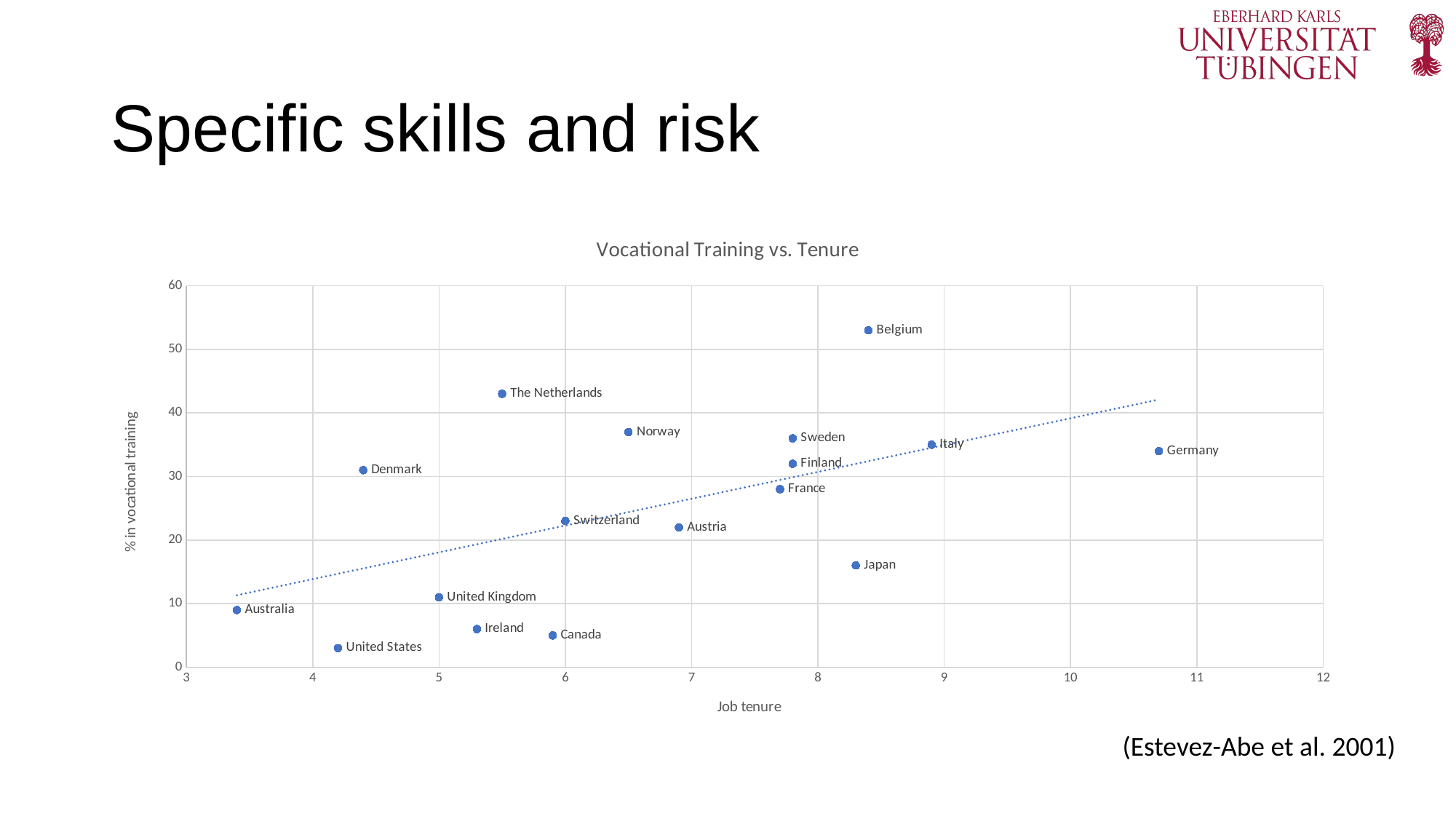
Which has a higher % in vocational training, Sweden or Finland? Sweden Is the job tenure for Germany greater or less than 10? greater Which country has the highest job tenure? Germany Which country has the highest % in vocational training? Belgium Which country has the lowest job tenure? Australia How many countries are plotted in the chart? 17 Is the % in vocational training for Belgium greater or less than 50? greater What is the label of the x axis? Job tenure What is the title of the chart? Vocational Training vs. Tenure Which country has the lowest % in vocational training? United States What type of chart is shown on the slide? Scatter chart Does the dotted trend line rise or fall as job tenure increases? Rises